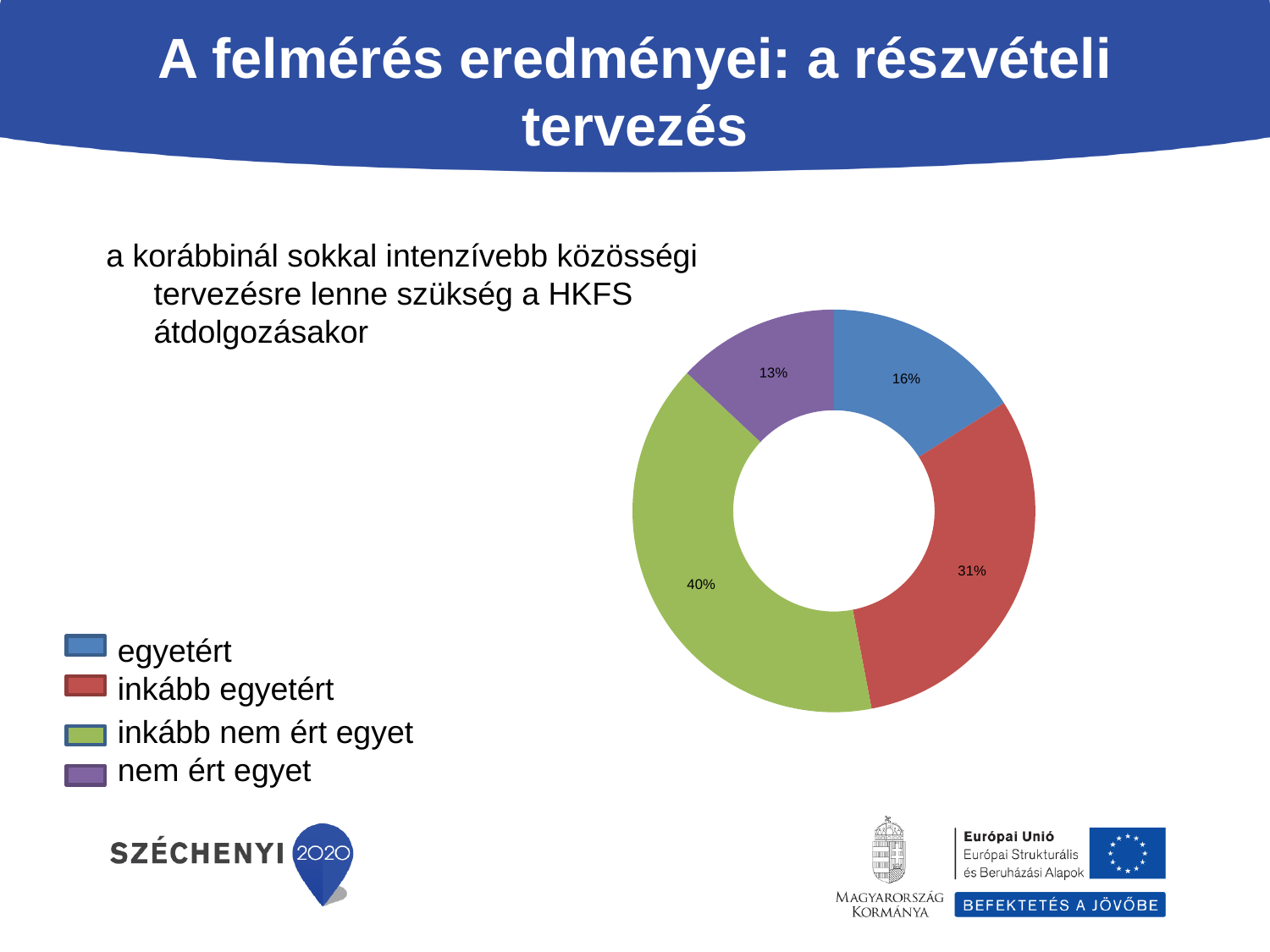
What is the combined share of "egyetért" and "inkább egyetért"? 47% How many slices does the chart have? 4 What kind of chart is shown on the slide? doughnut chart What percentage is shown for the "nem ért egyet" slice? 13% What is the difference in percentage points between "inkább nem ért egyet" and "inkább egyetért"? 9 What colour is the "inkább egyetért" slice? red Which is larger, the share for "egyetért" or the share for "nem ért egyet"? egyetért What percentage is shown for the "egyetért" slice? 16% What share of the doughnut chart is labelled "inkább nem ért egyet"? 40% Which category has the smallest share of the chart? nem ért egyet What percentage is shown for the "inkább egyetért" slice? 31% Which category has the largest share of the chart? inkább nem ért egyet